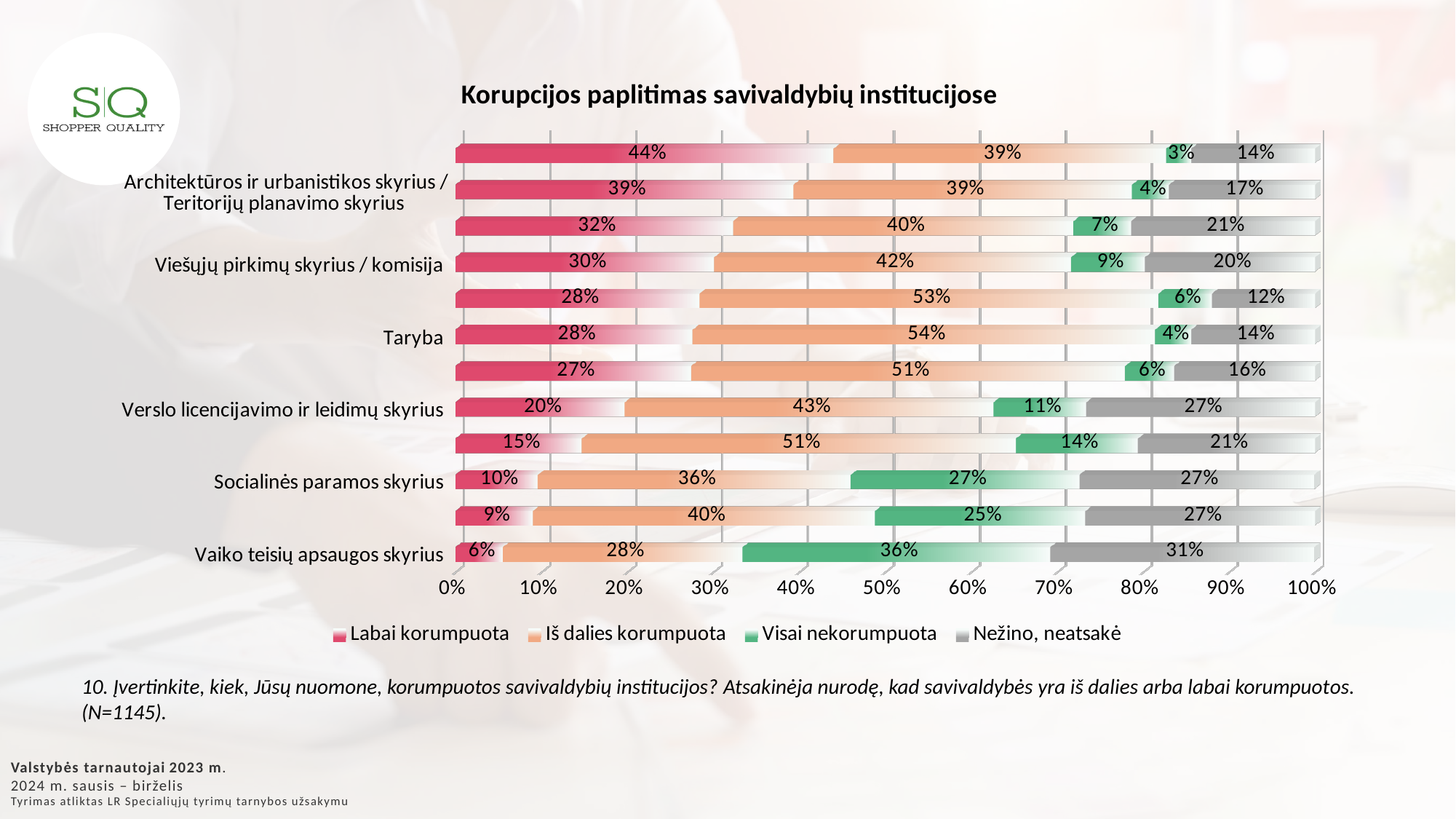
What is the value of "Nežino, neatsakė" for Architektūros ir urbanistikos skyrius / Teritorijų planavimo skyrius? 17% What is the title of the chart? Korupcijos paplitimas savivaldybių institucijose How many series does the legend list? 4 Which category has the highest "Visai nekorumpuota" value? Vaiko teisių apsaugos skyrius What is the value of "Visai nekorumpuota" for Socialinės paramos skyrius? 27% What is the value of "Nežino, neatsakė" for Viešųjų pirkimų skyrius / komisija? 20% What kind of chart is shown on the slide? Stacked bar chart What is the value of "Iš dalies korumpuota" for Vaiko teisių apsaugos skyrius? 28% Which category has the lowest "Labai korumpuota" value? Vaiko teisių apsaugos skyrius What is the value of "Labai korumpuota" for Taryba? 28% For Taryba, how much larger is the "Iš dalies korumpuota" value than the "Labai korumpuota" value? 26 percentage points Which has a larger "Labai korumpuota" value: Verslo licencijavimo ir leidimų skyrius or Socialinės paramos skyrius? Verslo licencijavimo ir leidimų skyrius